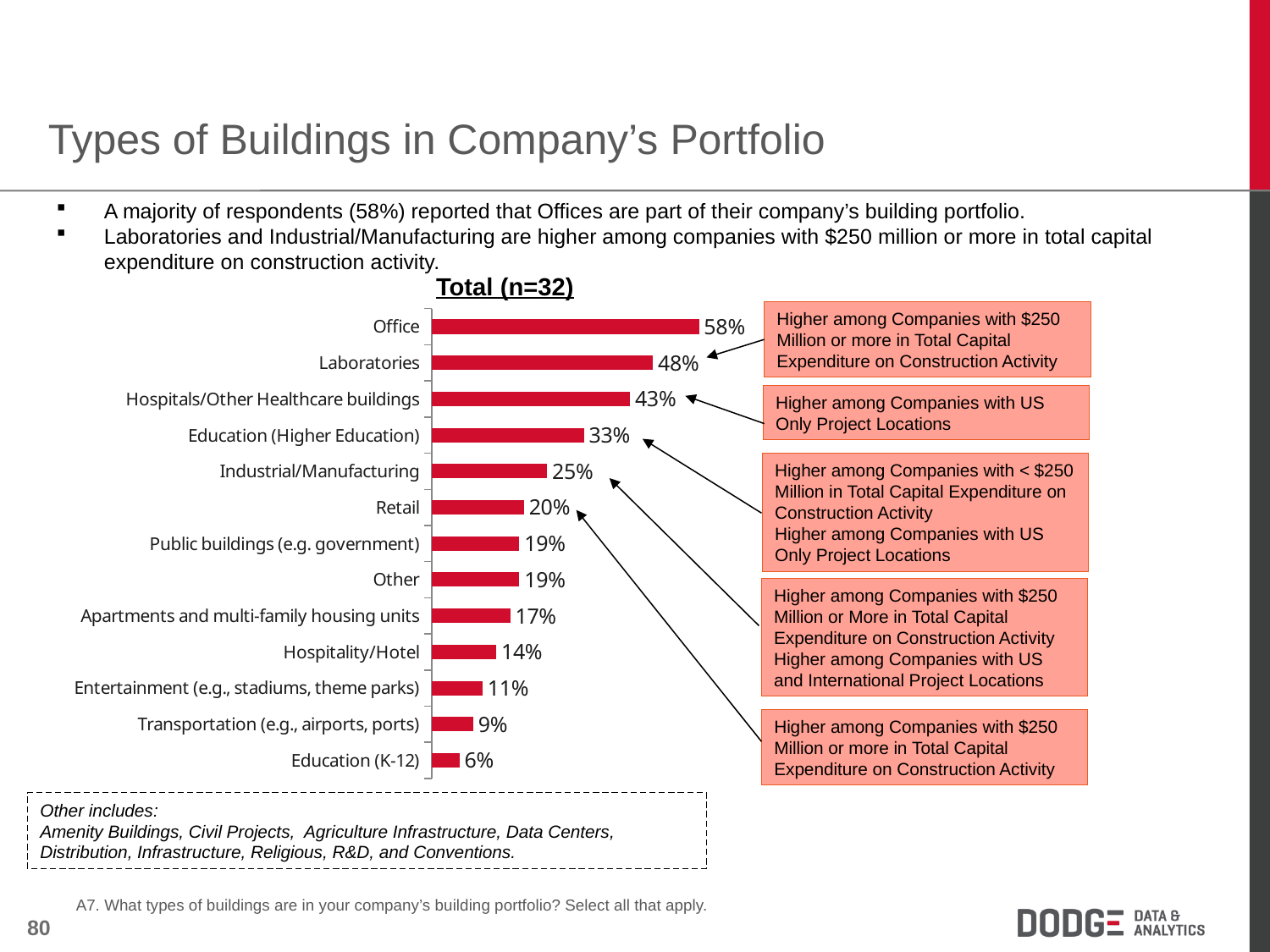
What is the difference between Education (Higher Education) and Education (K-12)? 27% What is the sample size shown in the chart title? n=32 What is the value for Hospitality/Hotel? 14% What is the difference between the values for Office and Laboratories? 10% What kind of chart is shown on the slide? Bar chart How many building types are shown in the chart? 13 What percentage of respondents reported Office buildings in their portfolio? 58% Which is larger, the value for Retail or the value for Industrial/Manufacturing? Industrial/Manufacturing What is the value for Transportation (e.g., airports, ports)? 9% Which building type has the highest percentage? Office What is the value for Hospitals/Other Healthcare buildings? 43% Which building type has the lowest percentage? Education (K-12)